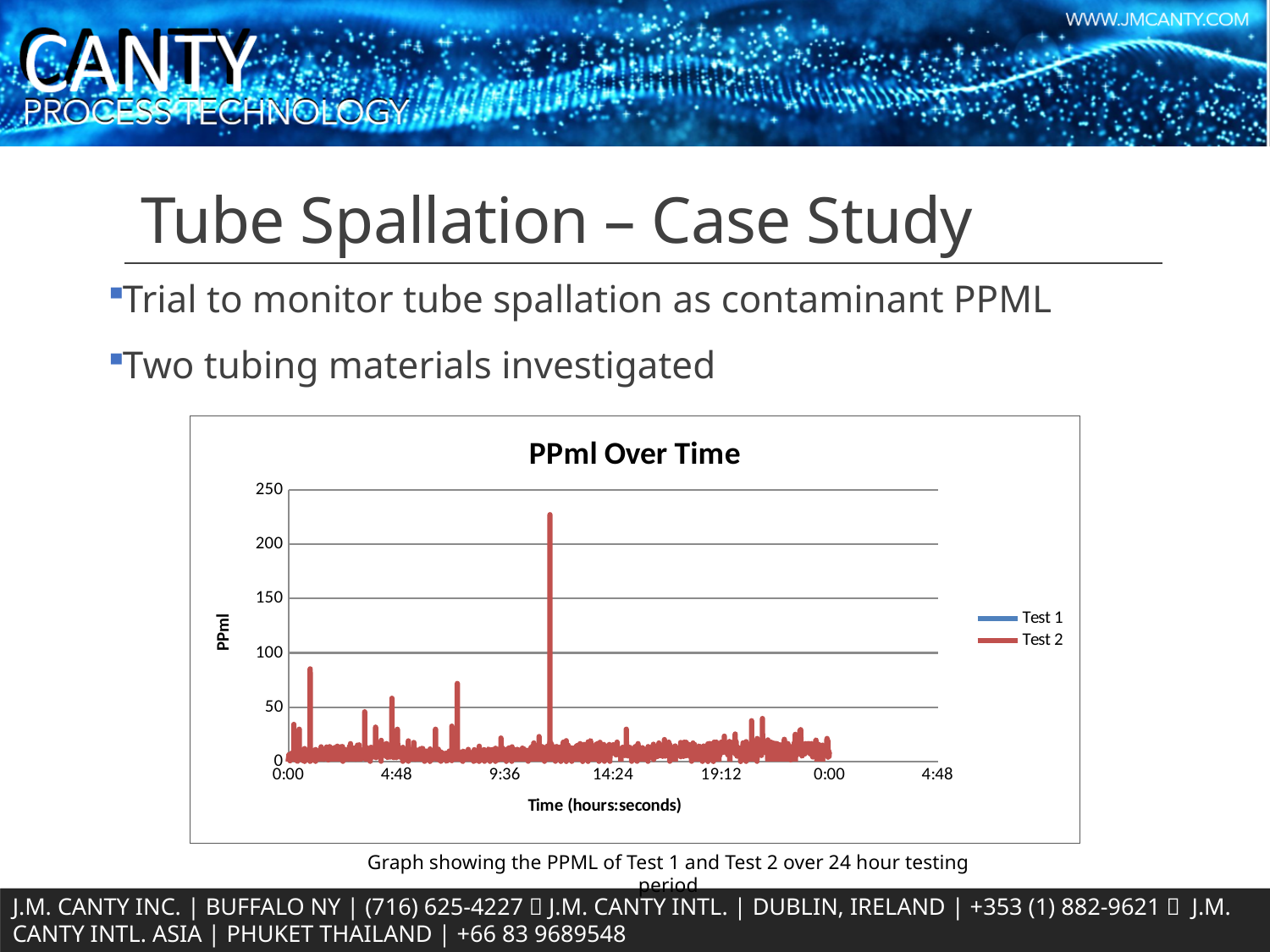
What is the highest tick value shown on the vertical axis of the chart? 250 Is the highest peak of the Test 2 series greater or less than 200? greater How many series does the legend of the chart list? 2 Is the highest peak of the Test 2 series greater or less than 250? less Apart from the single large spike, are most Test 2 values greater or less than 50? less What kind of chart is shown on the slide? line chart What is the title of the chart? PPml Over Time What is the label of the vertical axis of the chart? PPml Which series in the legend is drawn in red? Test 2 What is the first tick label on the horizontal axis of the chart? 0:00